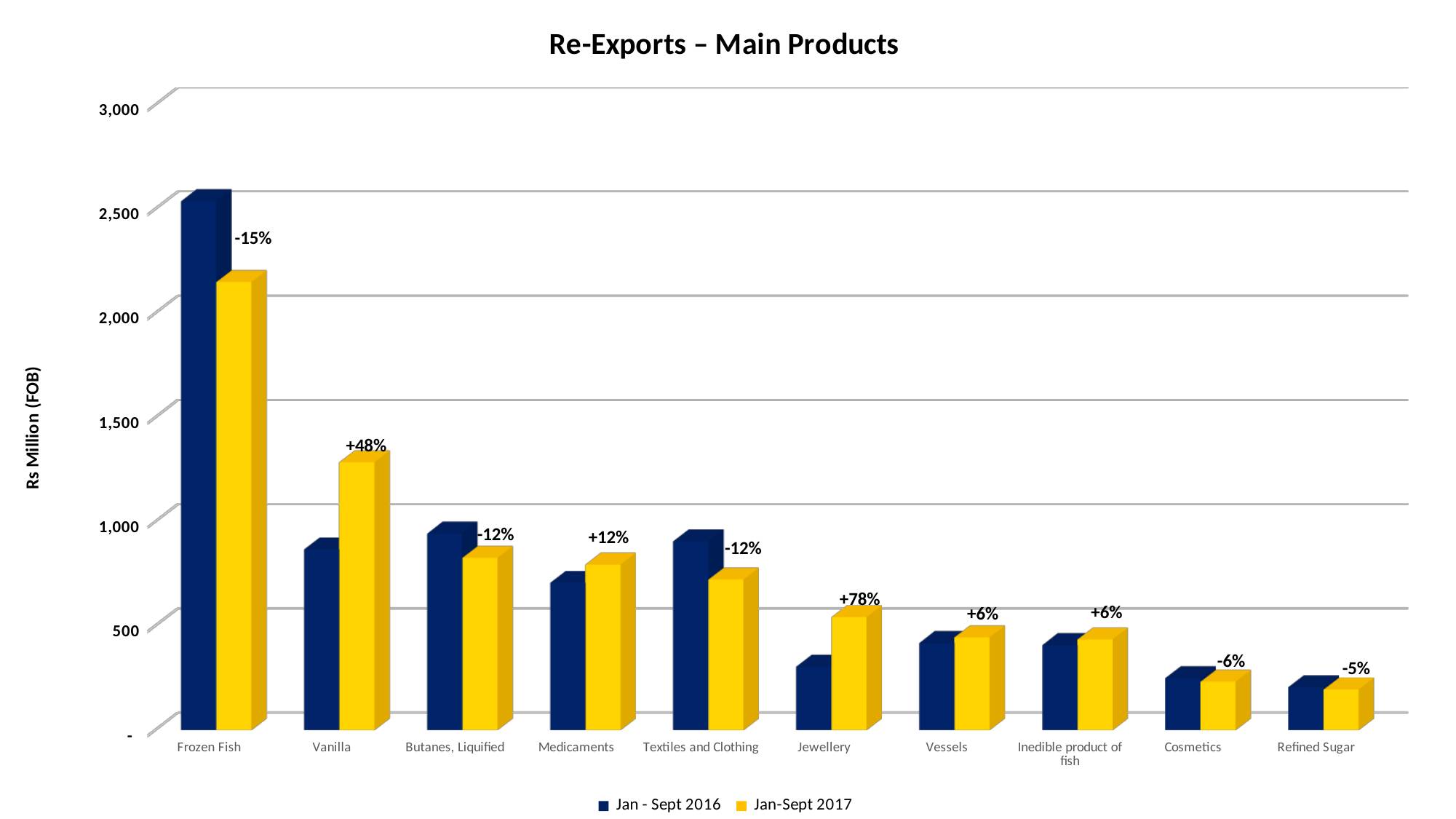
What percentage change label is shown for Frozen Fish? -15% How many product categories are shown on the x axis? 10 For Vanilla, which is larger: the Jan - Sept 2016 value or the Jan-Sept 2017 value? Jan-Sept 2017 What is the title of the chart? Re-Exports – Main Products What type of chart is shown on the slide? bar chart Which product has the lowest re-export value for Jan-Sept 2017? Refined Sugar Which product has the highest re-export value for Jan-Sept 2017? Frozen Fish What percentage change label is shown for Jewellery? +78% What percentage change label is shown for Vanilla? +48% How many series does the legend list? 2 Is the Jan-Sept 2017 value for Frozen Fish greater or less than 2,000? greater Is the Jan - Sept 2016 value for Jewellery greater or less than 500? less